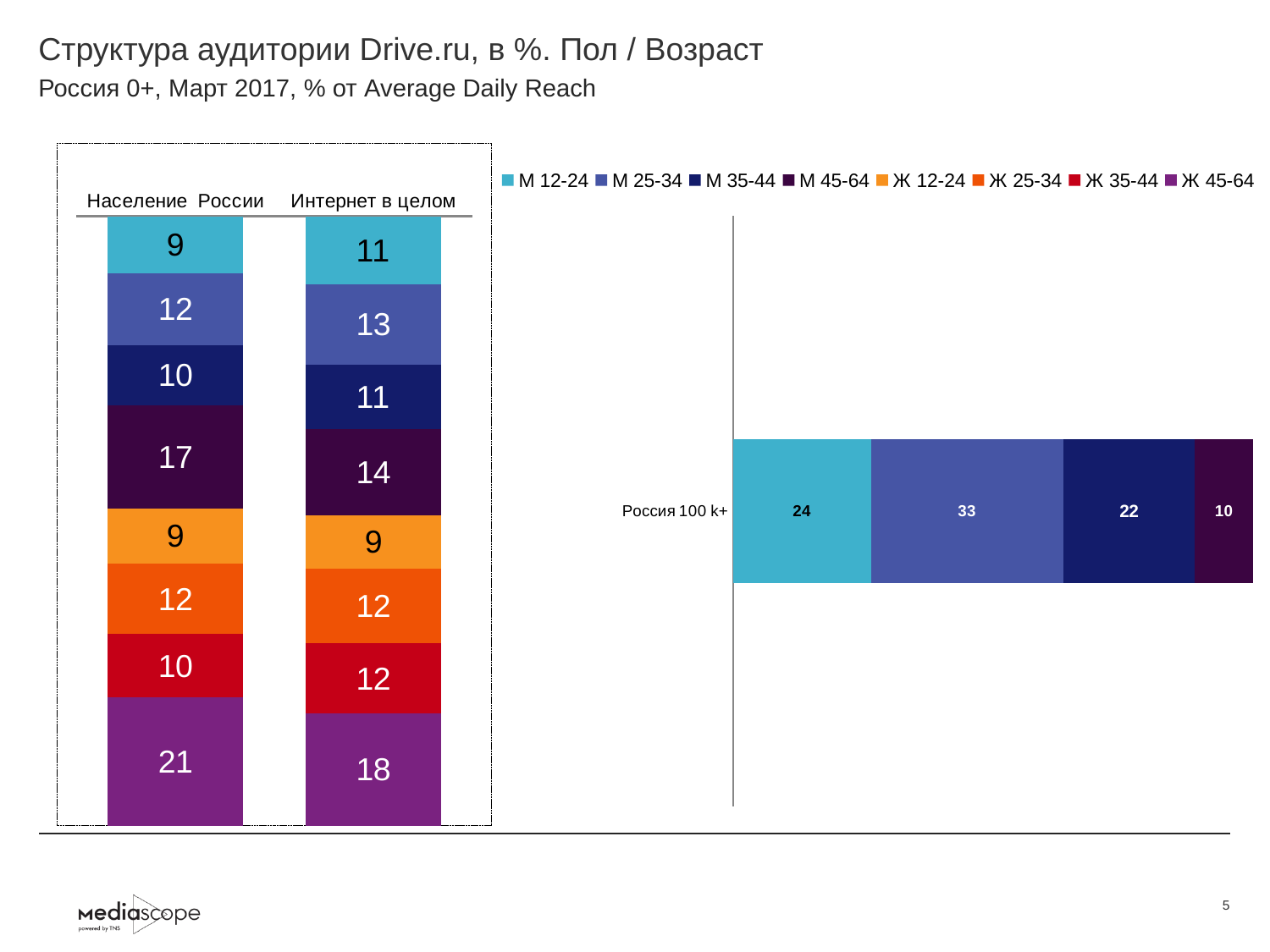
How many series does the legend list? 8 In the right-hand chart, which segment of the Россия 100 k+ bar is the smallest? М 45-64 In the left-hand chart, which is larger: the М 45-64 segment for Население России or for Интернет в целом? Население России In the right-hand chart, what is the value for М 25-34 for Россия 100 k+? 33 In the left-hand chart, what is the value of the bottom (Ж 45-64) segment for Население России? 21 In the left-hand chart, what is the difference between the Ж 45-64 segments for Население России and Интернет в целом? 3 In the left-hand chart, what is the value of the М 45-64 segment for Интернет в целом? 14 In the right-hand chart, what is the value for М 12-24 for Россия 100 k+? 24 In the right-hand chart, which segment of the Россия 100 k+ bar is the largest? М 25-34 In the right-hand chart, what is the difference between the М 25-34 and М 35-44 values for Россия 100 k+? 11 In the right-hand chart, what is the total of the four segments shown for Россия 100 k+? 89 What kind of chart is shown on the right-hand side of the slide? Stacked bar chart